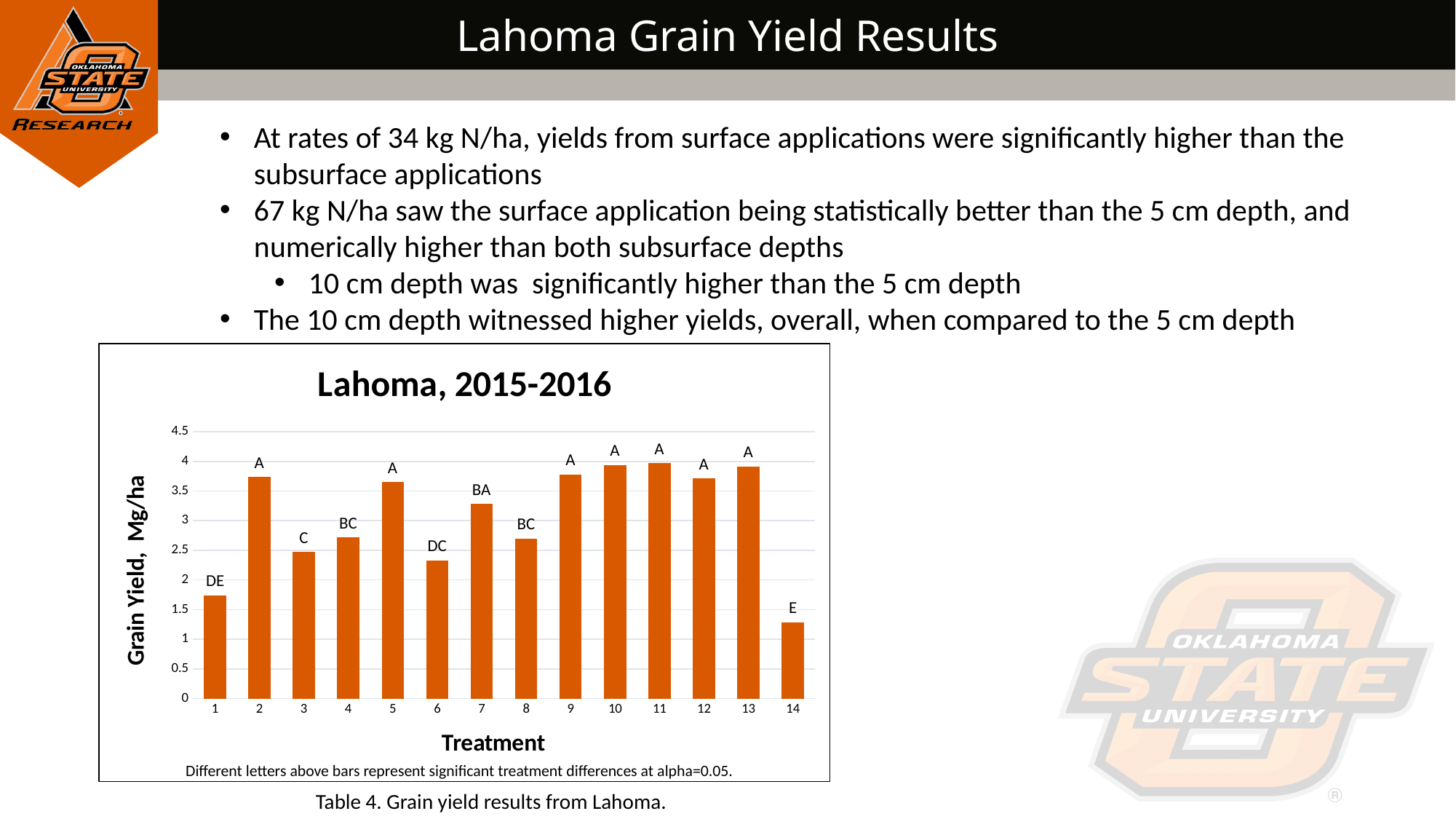
What is the title of the chart? Lahoma, 2015-2016 How many treatments are plotted on the x axis of the chart? 14 Which has the higher grain yield, treatment 5 or treatment 6? treatment 5 Is the grain yield for treatment 14 greater or less than 1.5? less Which treatment has the lowest grain yield? 14 What kind of chart is shown on the slide? bar chart Is the grain yield for treatment 7 greater or less than 3? greater What letter is shown above the bar for treatment 14? E Is the grain yield for treatment 2 greater or less than 3.5? greater Which has the higher grain yield, treatment 2 or treatment 3? treatment 2